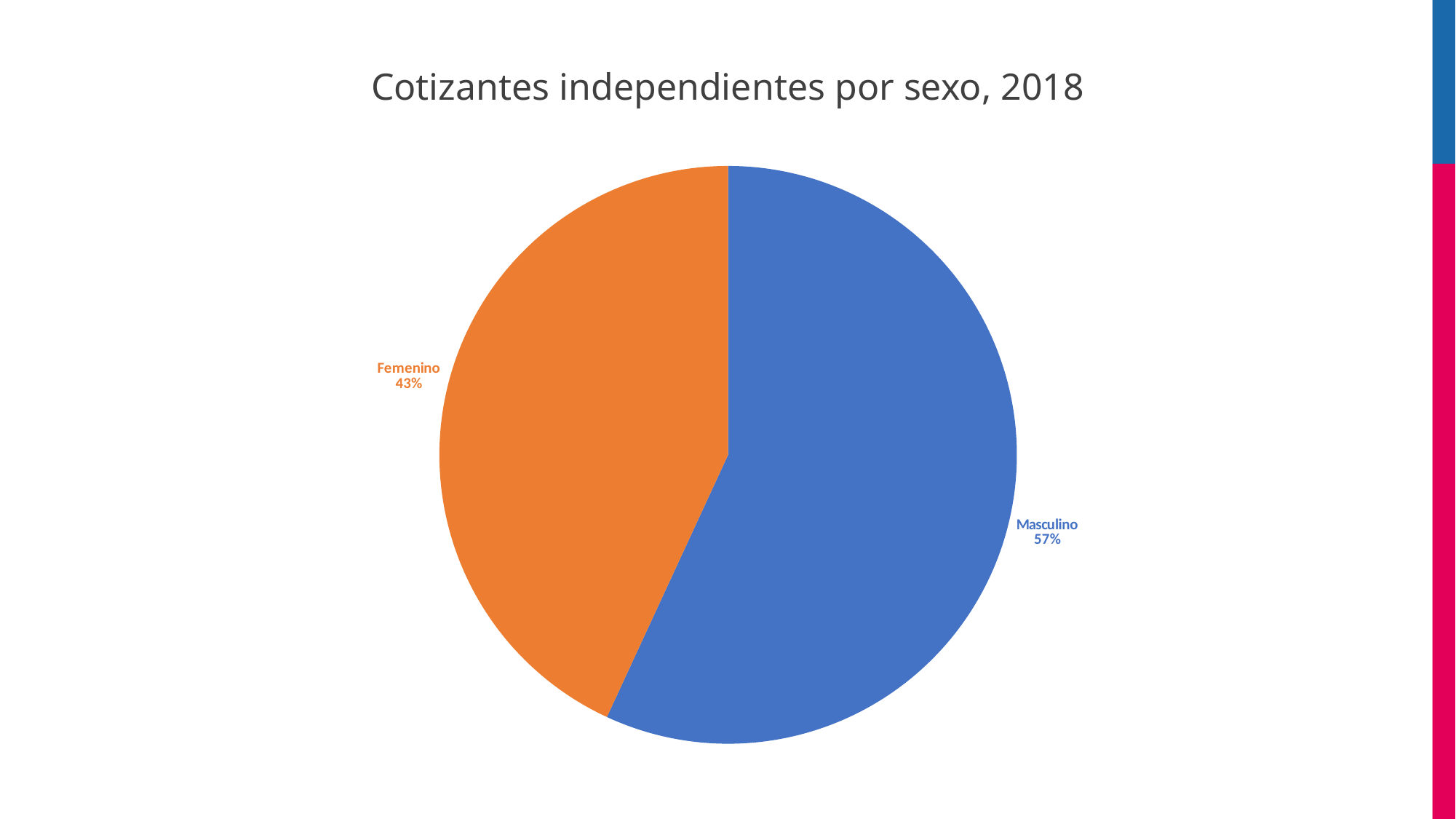
How many slices does the pie chart have? 2 Is the share for Masculino greater or less than 50%? greater What kind of chart is shown on the slide? Pie chart What is the difference in percentage points between the Masculino and Femenino slices? 14 What is the total of the two slices' percentages? 100% Which category has the smallest slice of the pie? Femenino Which category has the largest slice of the pie? Masculino Which slice is larger, Femenino or Masculino? Masculino What colour is the Femenino slice? Orange What is the title of the chart? Cotizantes independientes por sexo, 2018 What share of the pie does Femenino represent? 43% What share of the pie does Masculino represent? 57%